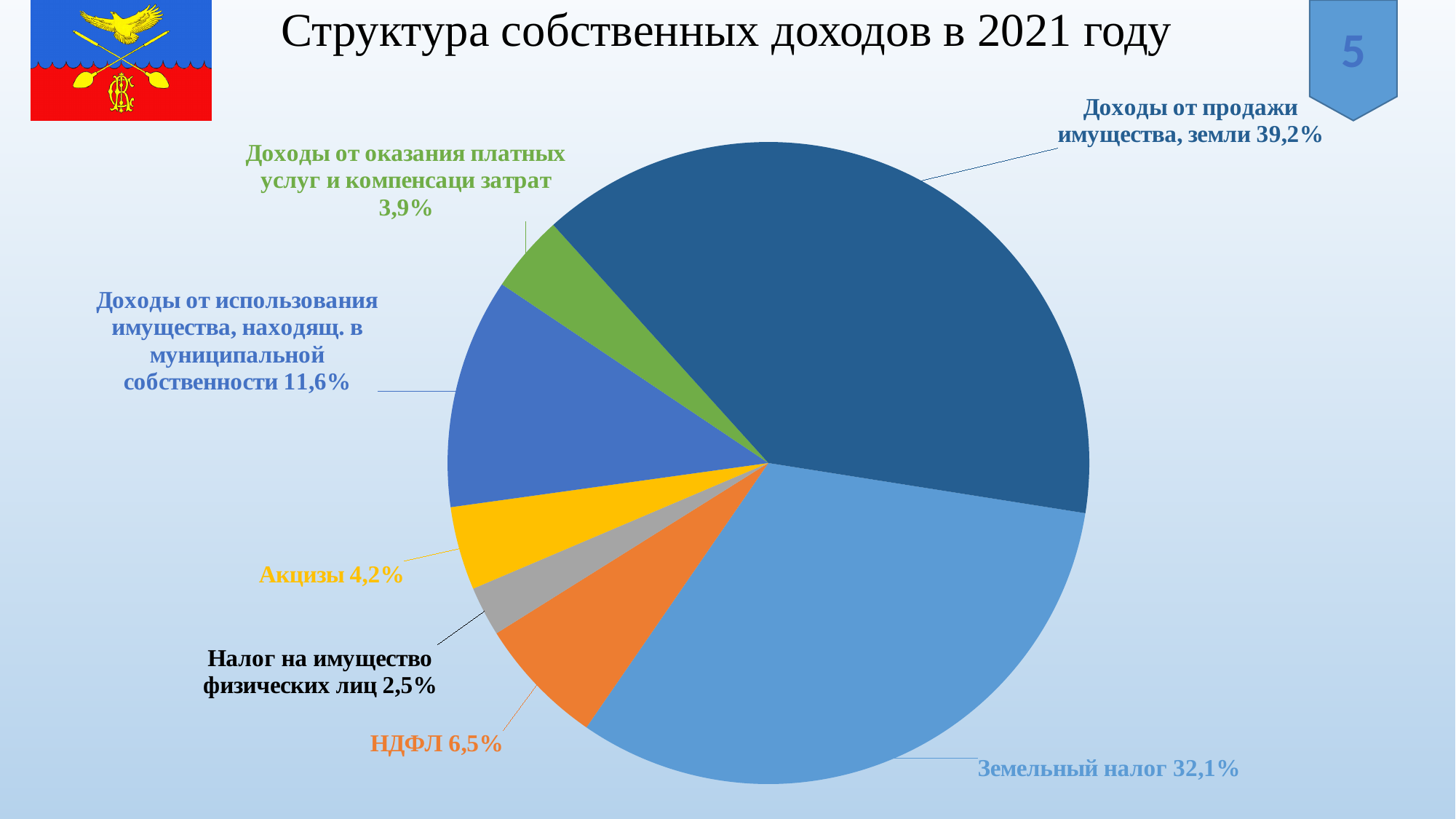
Какова доля НДФЛ в структуре собственных доходов? 6,5% Какова доля земельного налога в структуре собственных доходов в 2021 году? 32,1% Как называется диаграмма на слайде? Структура собственных доходов в 2021 году На сколько процентных пунктов доля доходов от продажи имущества, земли больше доли земельного налога? 7,1 Какова суммарная доля земельного налога и НДФЛ? 38,6% Какой тип диаграммы показан на слайде? Круговая диаграмма Сколько категорий показано на круговой диаграмме? 7 Какова доля доходов от использования имущества, находящегося в муниципальной собственности? 11,6% Какая категория имеет наименьшую долю в структуре собственных доходов? Налог на имущество физических лиц Что больше: доля акцизов или доля доходов от оказания платных услуг и компенсации затрат? Акцизы Какова доля акцизов? 4,2% Какая категория имеет наибольшую долю в структуре собственных доходов? Доходы от продажи имущества, земли